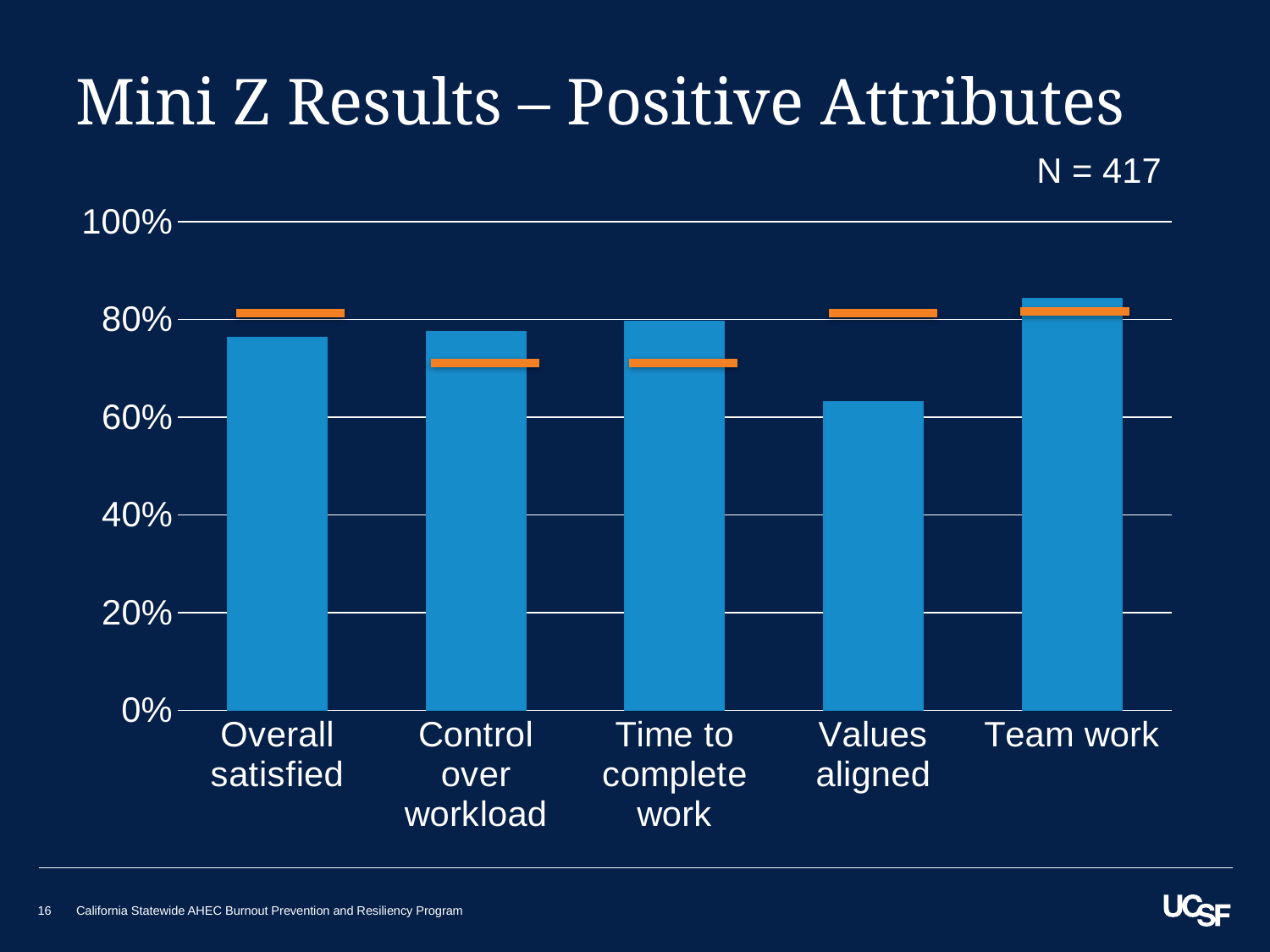
Is the value for Team work greater or less than 80%? greater Which is larger, the value for Overall satisfied or the value for Values aligned? Overall satisfied Which is larger, the value for Team work or the value for Values aligned? Team work What is the title of the chart on the slide? Mini Z Results – Positive Attributes Which category has the lowest bar in the chart? Values aligned What kind of chart is shown on the slide? bar chart Is the value for Overall satisfied greater or less than 80%? less Is the value for Values aligned greater or less than 60%? greater Which category has the highest bar in the chart? Team work How many categories are shown on the x axis of the chart? 5